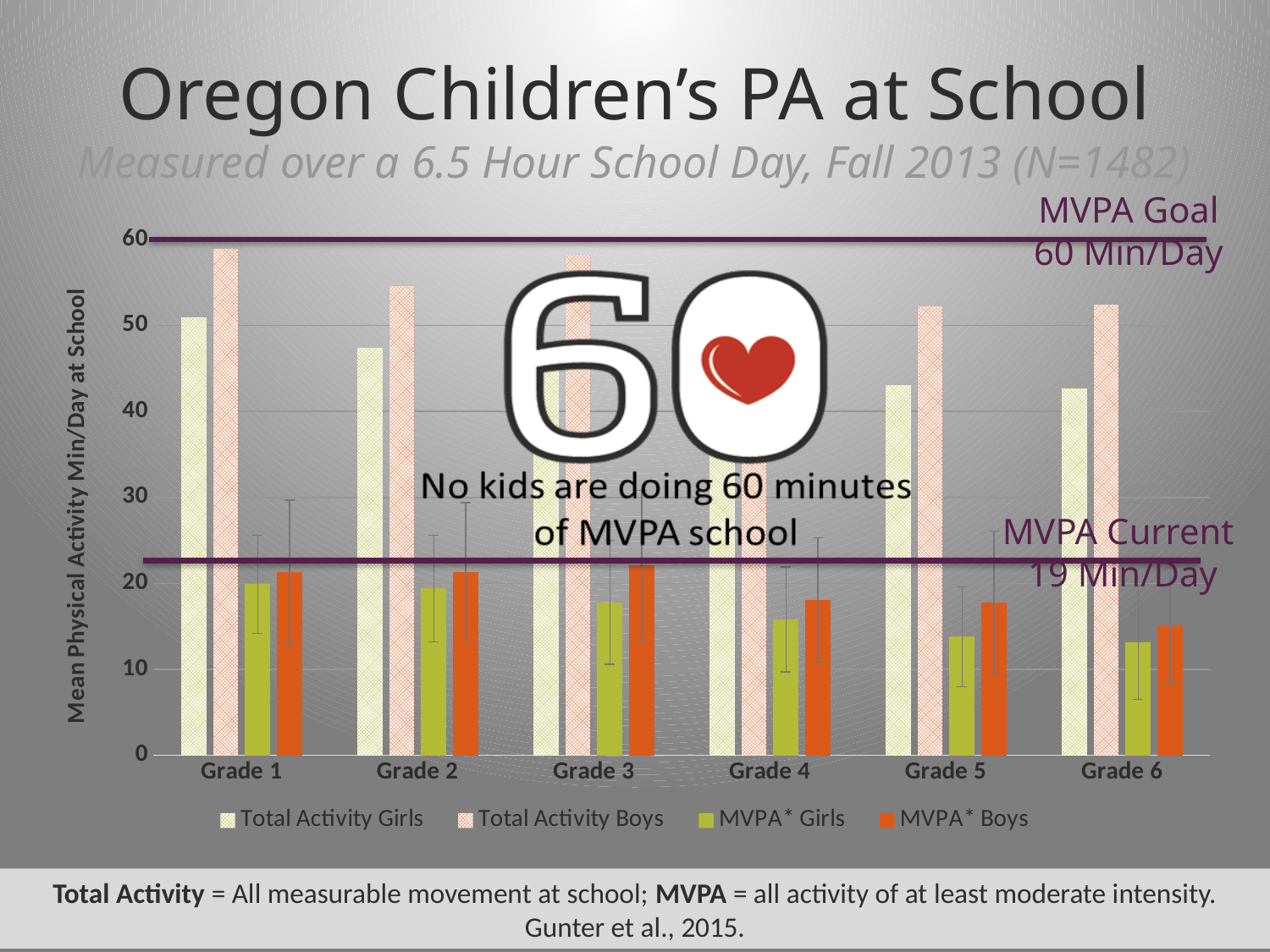
Is the MVPA* Girls value for Grade 6 greater or less than 20? less Which is larger: MVPA* Girls for Grade 1 or MVPA* Girls for Grade 6? Grade 1 Is the Total Activity Boys value for Grade 1 greater or less than 50? greater Is the Total Activity Girls value for Grade 5 greater or less than 40? greater For Grade 1, which is larger: Total Activity Girls or Total Activity Boys? Total Activity Boys What kind of chart is shown on the slide? bar chart What is the MVPA goal shown on the chart, in minutes per day? 60 Min/Day Do the MVPA* Girls values rise or fall from Grade 1 to Grade 6? fall How many series does the legend list? 4 How many grade categories are shown on the x axis? 6